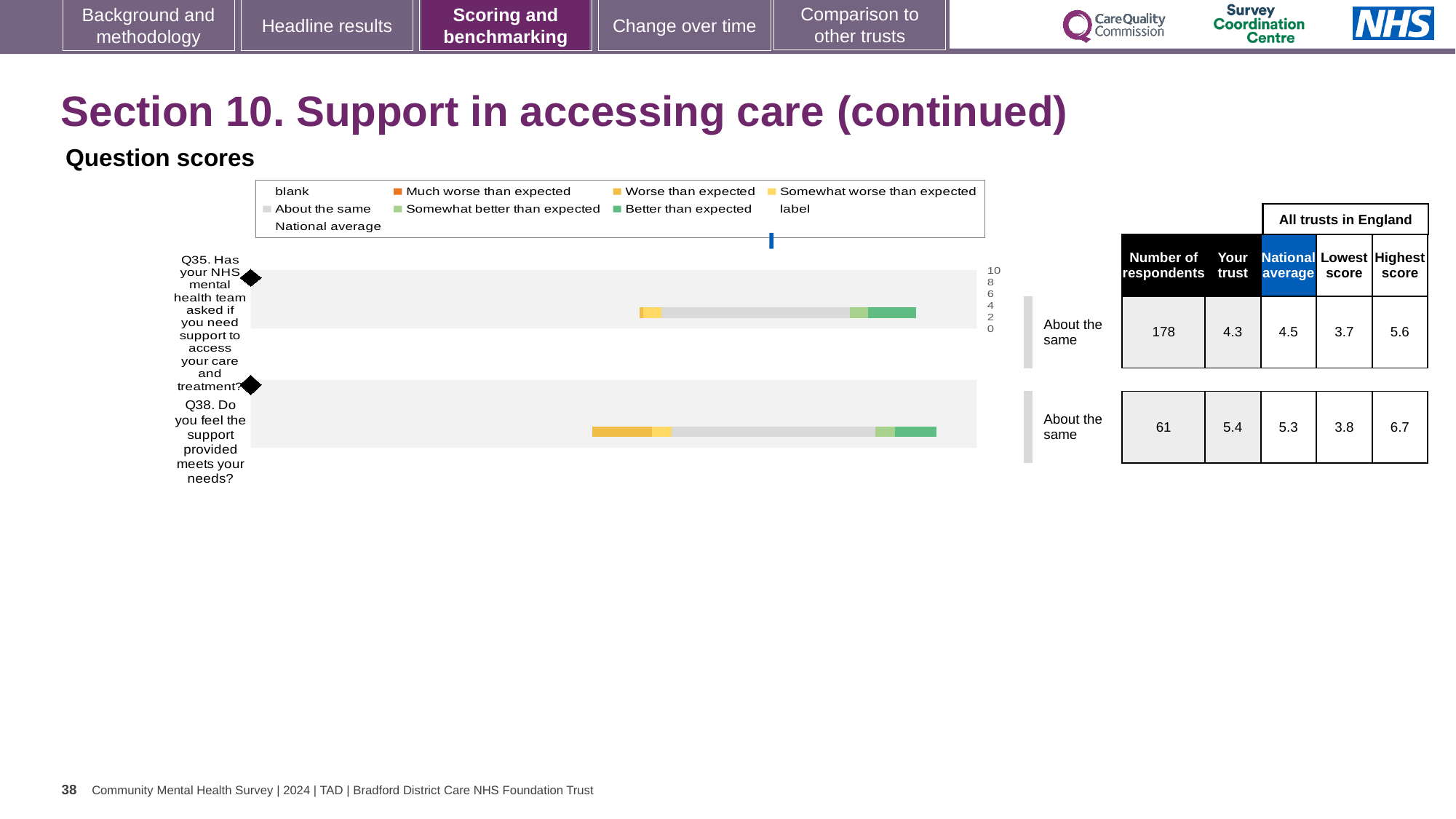
What benchmark category is shown next to the bar for Q38? About the same What is the highest score among all trusts in England for Q38? 6.7 What is the national average score for Q35? 4.5 What is the difference between the highest score and the lowest score for Q35? 1.9 How many respondents answered Q38? 61 For Q38, which is larger: the 'Your trust' score or the national average? Your trust How many questions are plotted in the question scores chart? 2 What is the 'Your trust' score for Q35 (Has your NHS mental health team asked if you need support to access your care and treatment?)? 4.3 For Q35, which is larger: the 'Your trust' score or the national average? National average Which question has the larger number of respondents? Q35 What kind of chart is used to show the question scores on this slide? bar chart What is the 'Your trust' score for Q38 (Do you feel the support provided meets your needs?)? 5.4